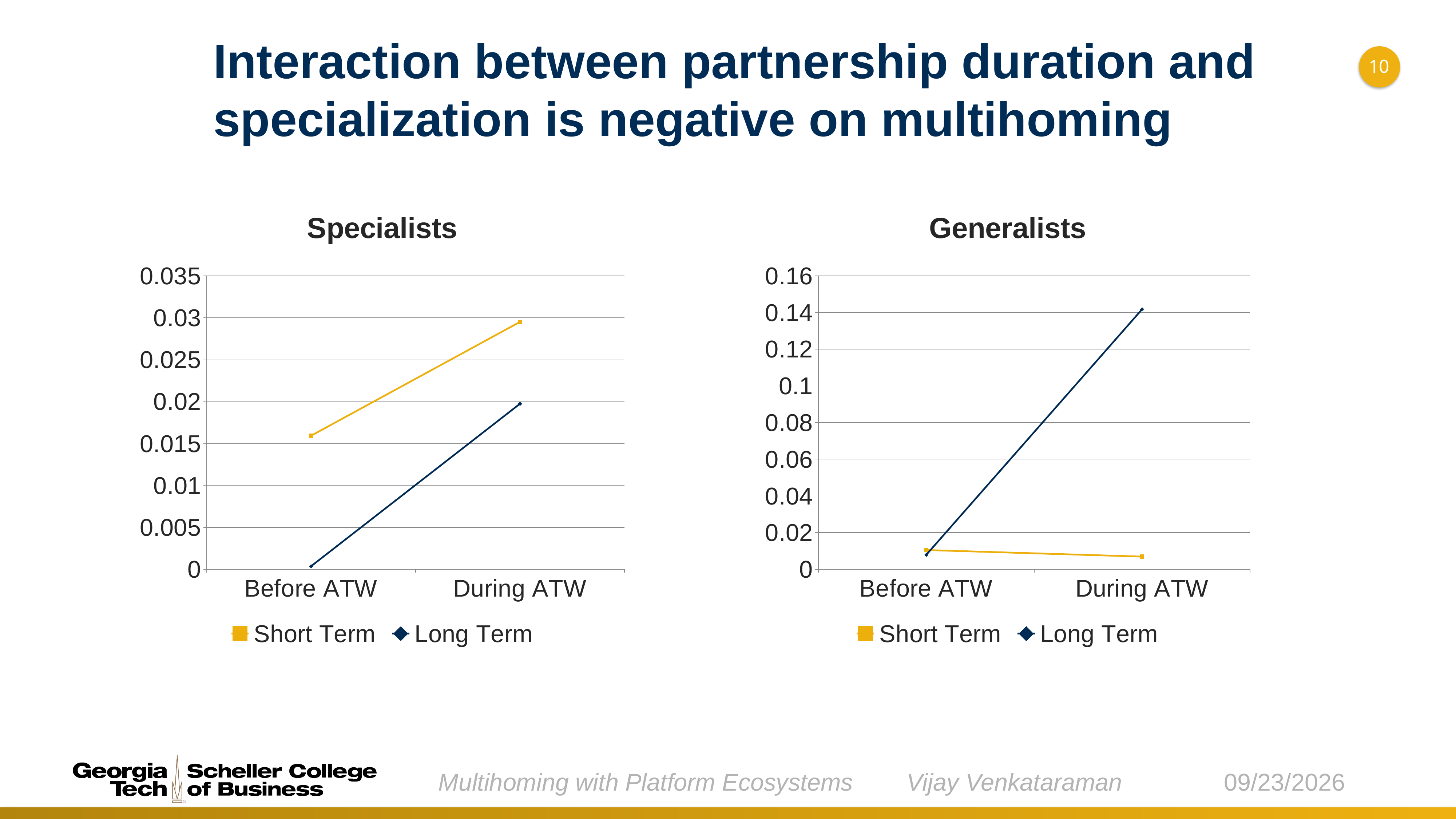
In the Generalists chart, does the Short Term series rise or fall from Before ATW to During ATW? fall In the Generalists chart, does the Long Term series rise or fall from Before ATW to During ATW? rise In the Generalists chart, which series has the larger value at During ATW, Short Term or Long Term? Long Term In the Specialists chart, does the Short Term series rise or fall from Before ATW to During ATW? rise In the Generalists chart, is the Short Term value for During ATW greater or less than 0.02? less What kind of chart is the Specialists chart? line chart In the Specialists chart, which series has the larger value at Before ATW, Short Term or Long Term? Short Term In the Specialists chart, is the Long Term value for Before ATW greater or less than 0.005? less How many categories are on the x axis of the Specialists chart? 2 In the Generalists chart, is the Long Term value for During ATW greater or less than 0.12? greater How many series does the legend of the Generalists chart list? 2